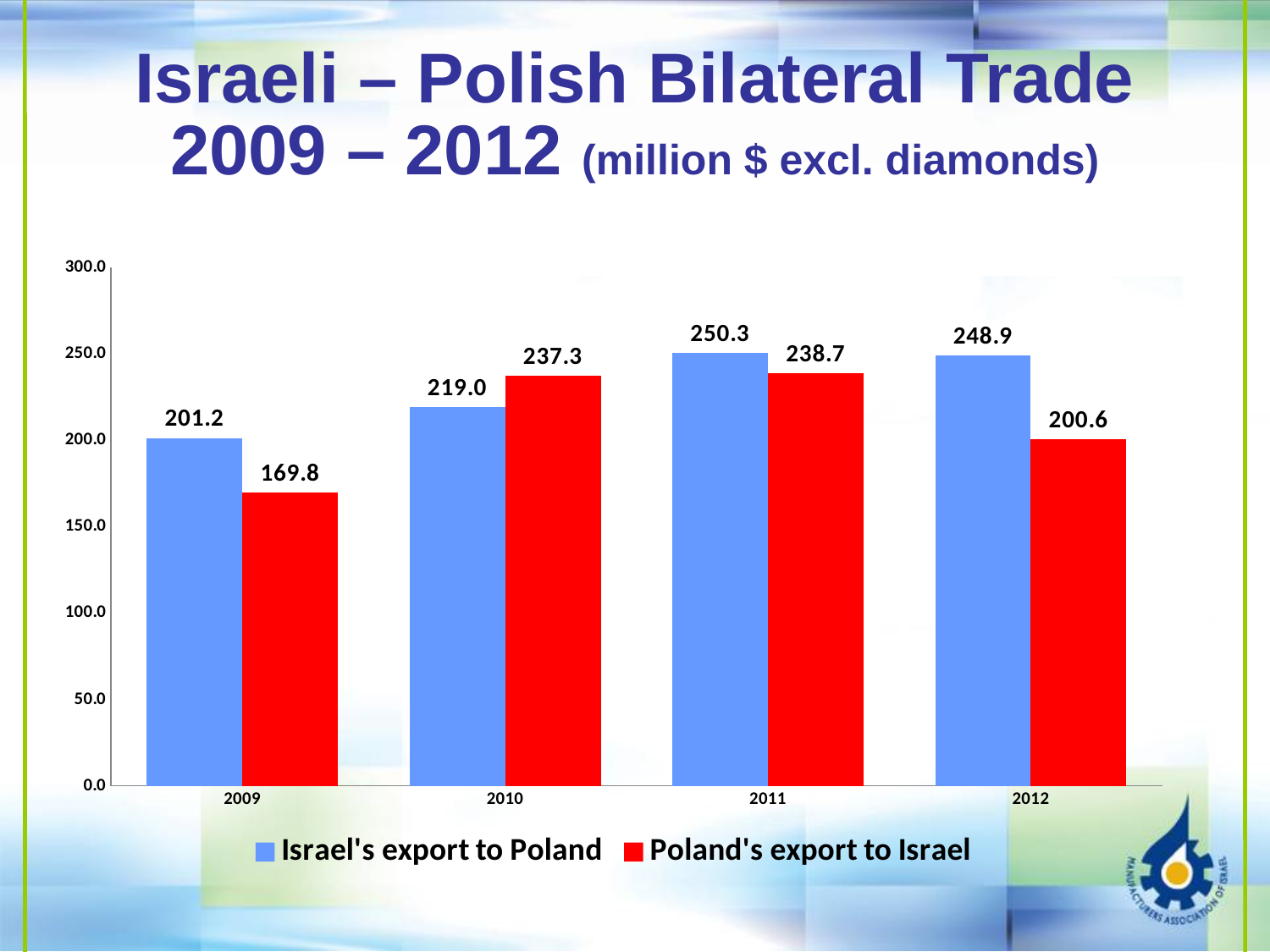
What was Israel's export to Poland in 2009? 201.2 In which year was Poland's export to Israel lowest? 2009 Which was larger in 2010: Israel's export to Poland or Poland's export to Israel? Poland's export to Israel What is the difference between Israel's export to Poland in 2012 and Poland's export to Israel in 2012? 48.3 What was Poland's export to Israel in 2012? 200.6 In which year was Israel's export to Poland highest? 2011 How many years are shown on the x axis? 4 What kind of chart is shown on the slide? Bar chart What was Poland's export to Israel in 2010? 237.3 What is the difference between Israel's export to Poland and Poland's export to Israel in 2009? 31.4 Which colour represents Poland's export to Israel in the chart? Red How many series does the legend list? 2